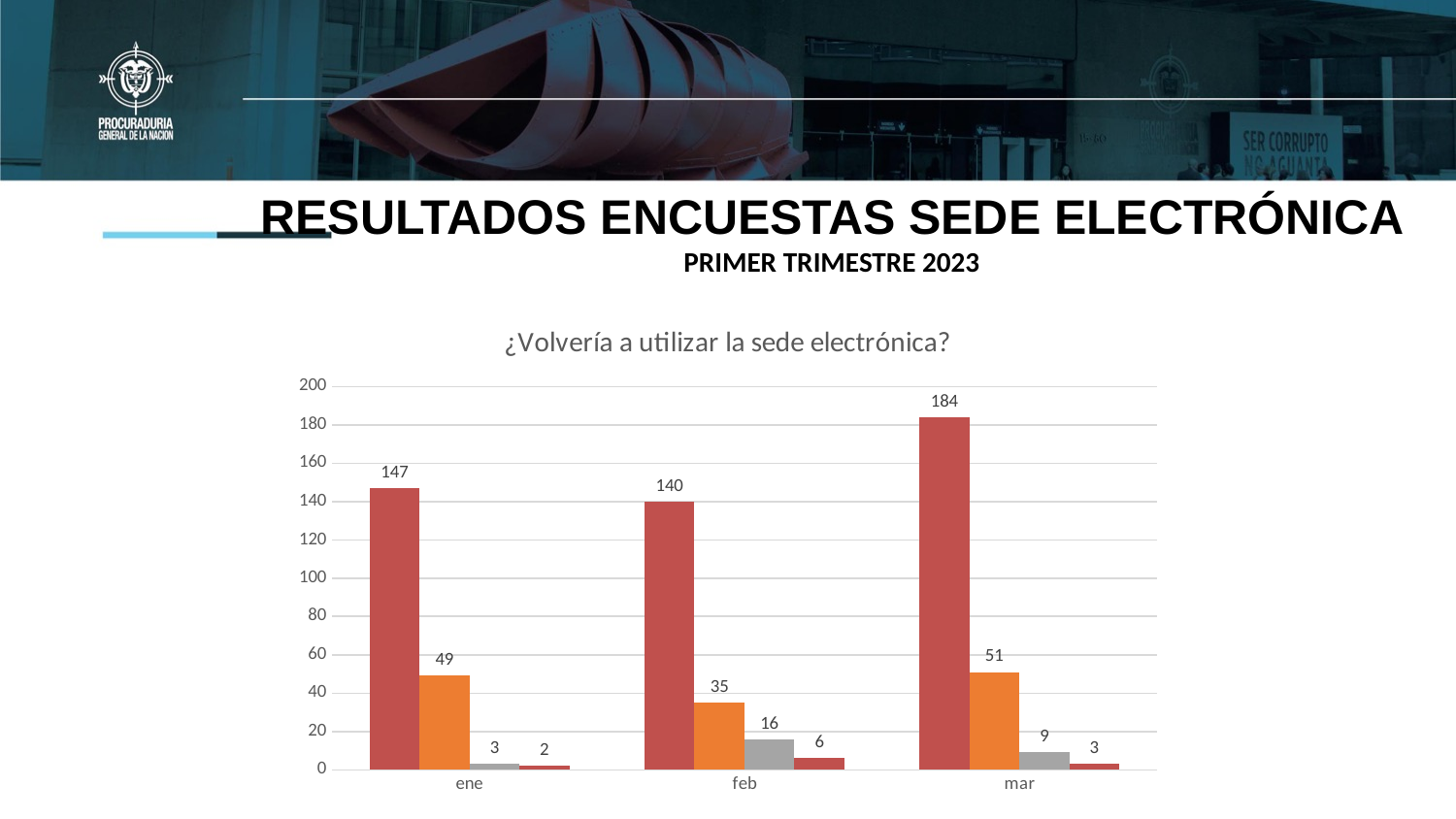
Which is larger, the orange bar for ene or the orange bar for mar? mar Is the tallest bar for feb greater or less than 160? less In which month is the tallest (dark red) bar lowest? feb In which month is the tallest (dark red) bar highest? mar What kind of chart is shown on the slide? bar chart What is the chart title? ¿Volvería a utilizar la sede electrónica? What is the value of the smallest (red) bar for feb? 6 How many categories are shown on the x axis? 3 What is the value of the tallest (dark red) bar for mar? 184 What is the difference between the tallest bar for mar (184) and the tallest bar for ene (147)? 37 What is the value of the gray bar for ene? 3 What is the value of the orange bar for feb? 35